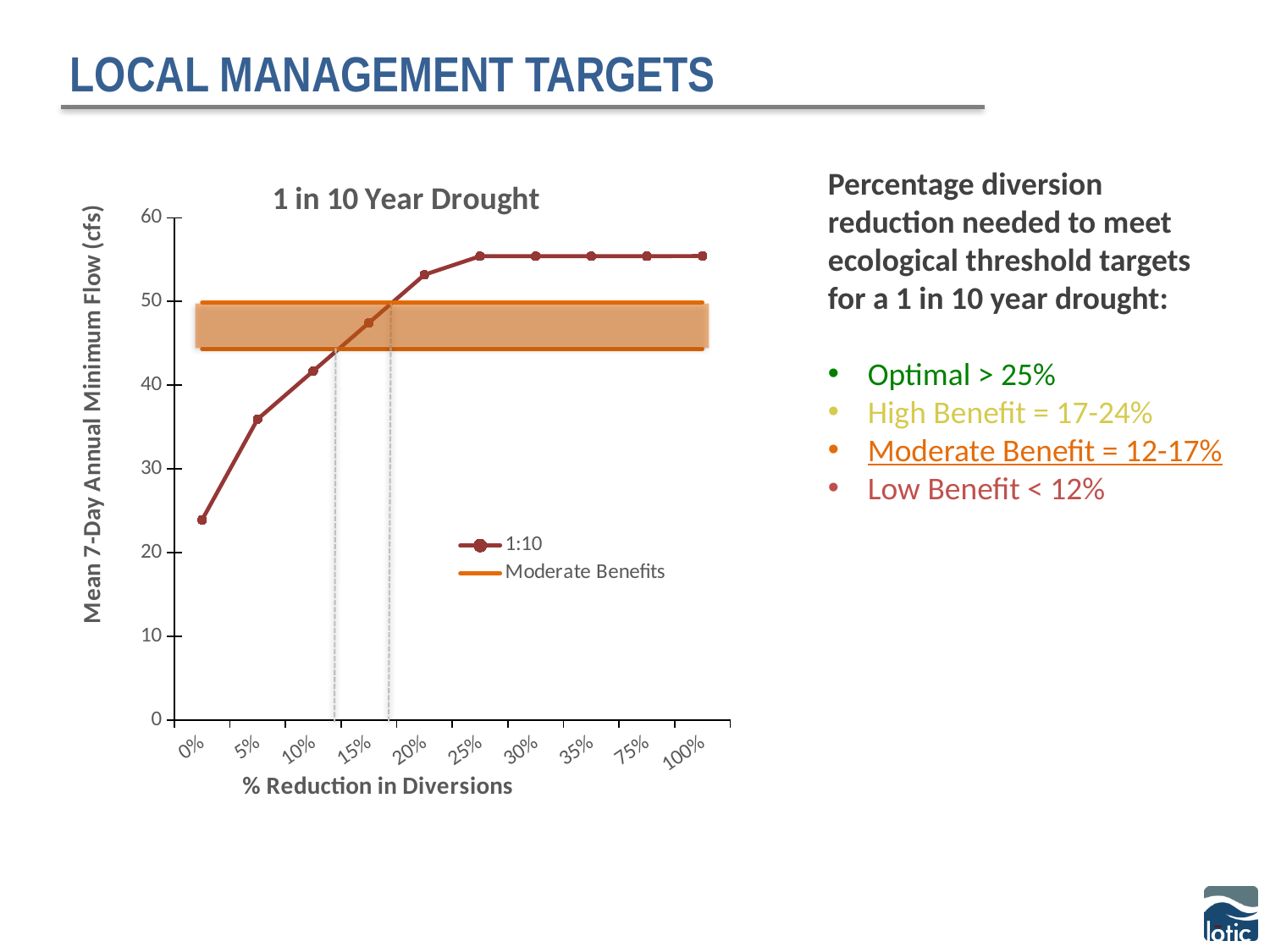
What kind of chart is shown on the slide? Line chart Is the 1:10 value at 15% reduction in diversions greater or less than 40? greater Does the 1:10 series rise or fall from 0% to 20% reduction in diversions? Rise Which is larger for the 1:10 series: the value at 0% or the value at 5%? 5% Is the 1:10 value at 0% reduction in diversions greater or less than 30? less How many categories are shown on the x axis of the chart? 10 Is the 1:10 value at 100% reduction in diversions greater or less than 50? greater What is the label of the y axis of the chart? Mean 7-Day Annual Minimum Flow (cfs) Which category has the lowest value for the 1:10 series? 0% How many series does the chart legend list? 2 What is the title of the chart? 1 in 10 Year Drought